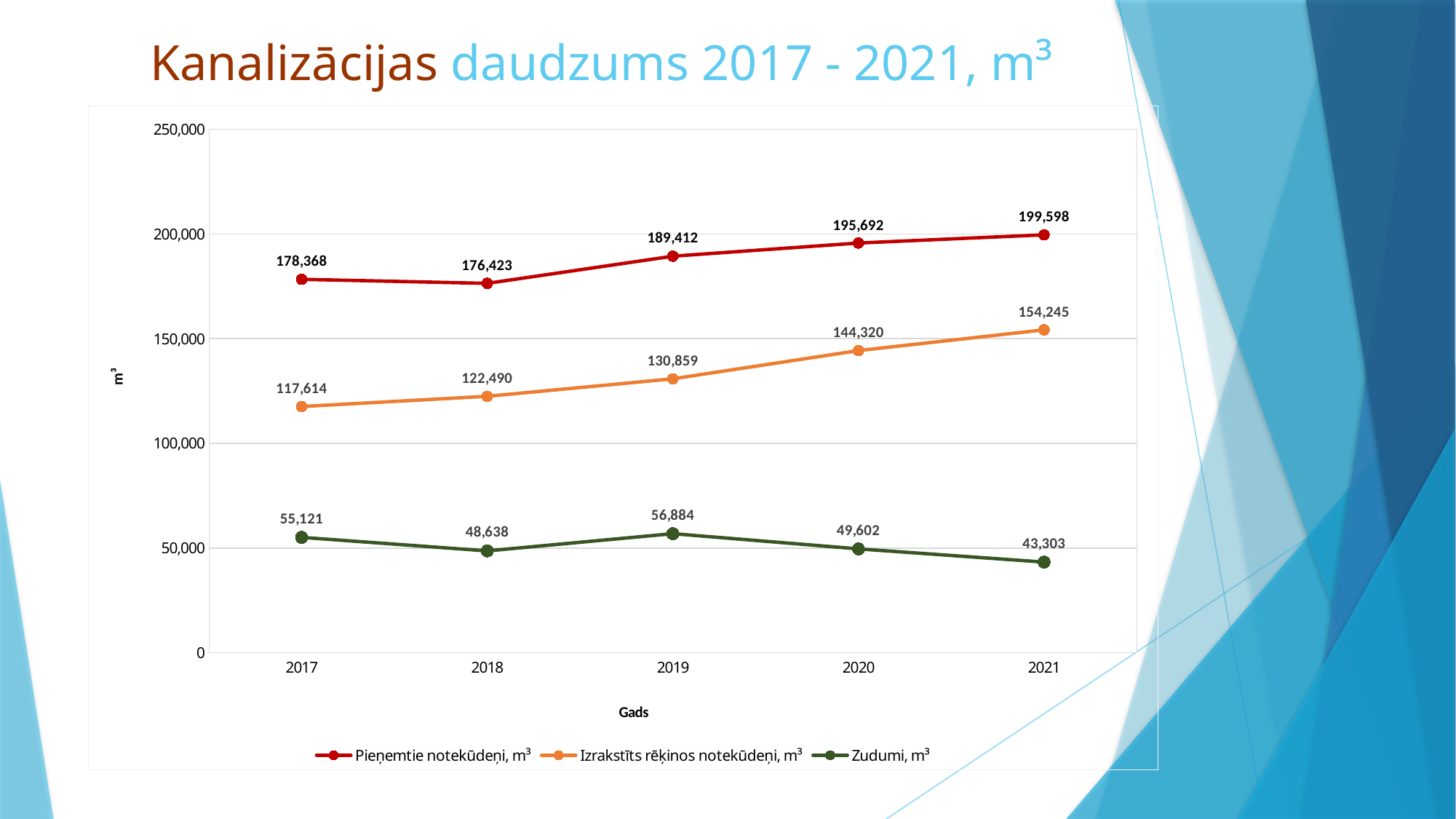
In which year is Zudumi, m³ highest? 2019 What is the value of Pieņemtie notekūdeņi, m³ in 2019? 189,412 How many series does the legend list? 3 Which is larger: Zudumi, m³ in 2017 or Zudumi, m³ in 2018? 2017 Does Izrakstīts rēķinos notekūdeņi, m³ rise or fall from 2017 to 2021? rise What is the difference between Pieņemtie notekūdeņi, m³ and Izrakstīts rēķinos notekūdeņi, m³ in 2021? 45,353 In which year is Pieņemtie notekūdeņi, m³ lowest? 2018 Is the value for Izrakstīts rēķinos notekūdeņi, m³ in 2021 greater or less than 150,000? greater How many years are shown on the x axis? 5 What is the value of Izrakstīts rēķinos notekūdeņi, m³ in 2020? 144,320 What is the value of Zudumi, m³ in 2021? 43,303 What kind of chart is shown on the slide? line chart